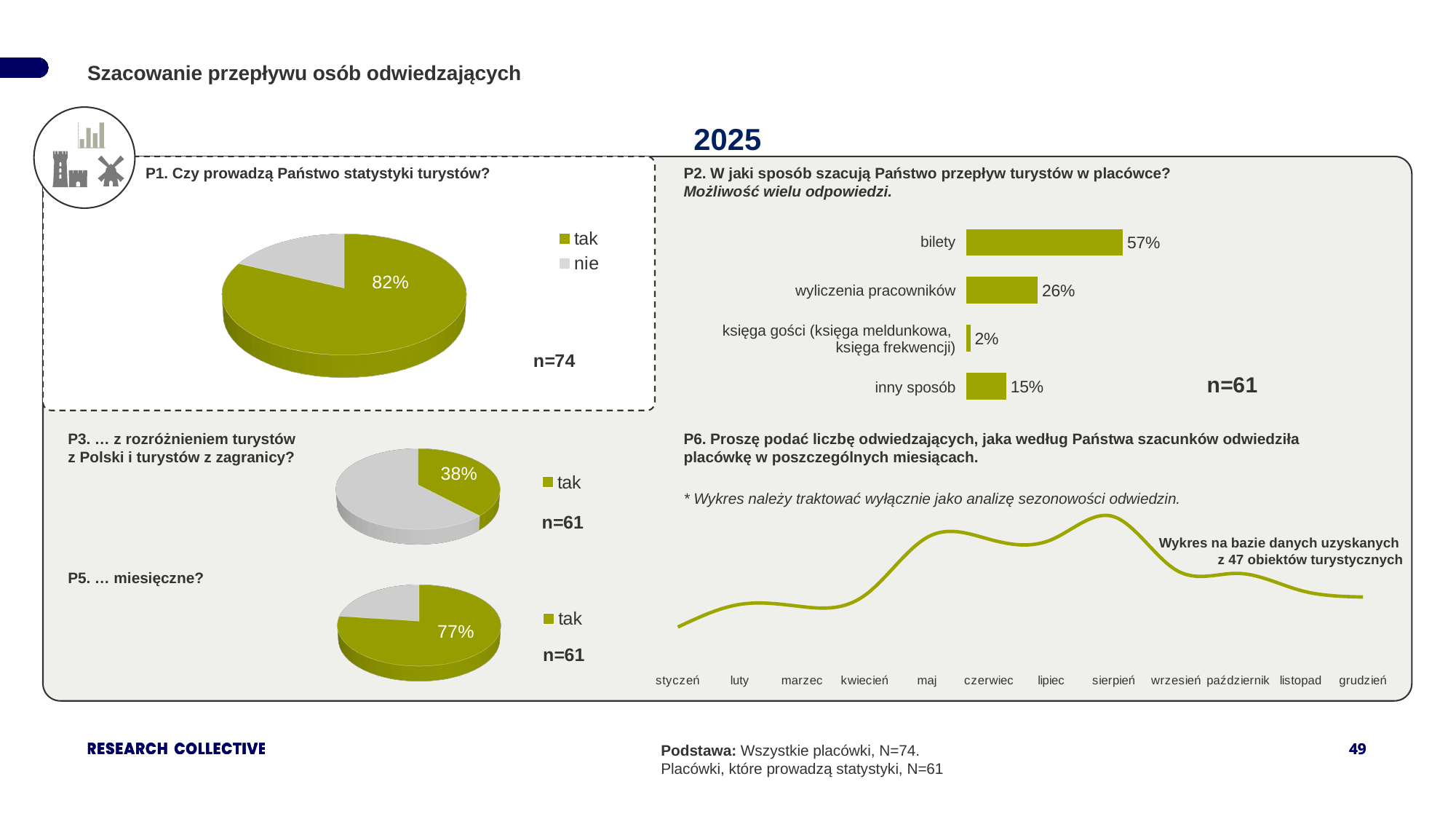
In the P1 pie chart (Czy prowadzą Państwo statystyki turystów?), what share of respondents answered "tak"? 82% In the P2 bar chart, what is the value for "wyliczenia pracowników"? 26% In the P5 pie chart (miesięczne), what share answered "tak"? 77% What type of chart is used for P6 (number of visitors per month)? line chart In the P2 bar chart, which category has the highest value? bilety How many legend entries does the P1 pie chart show? 2 In the P2 bar chart, which is larger: "wyliczenia pracowników" or "inny sposób"? wyliczenia pracowników In the P2 bar chart, how many categories are shown? 4 In the P2 bar chart, what is the value for "bilety"? 57% In the P2 bar chart, what is the difference between the values for "bilety" and "inny sposób"? 42% In the P3 pie chart (z rozróżnieniem turystów z Polski i turystów z zagranicy), what share answered "tak"? 38% In the P2 bar chart, which category has the lowest value? księga gości (księga meldunkowa, księga frekwencji)